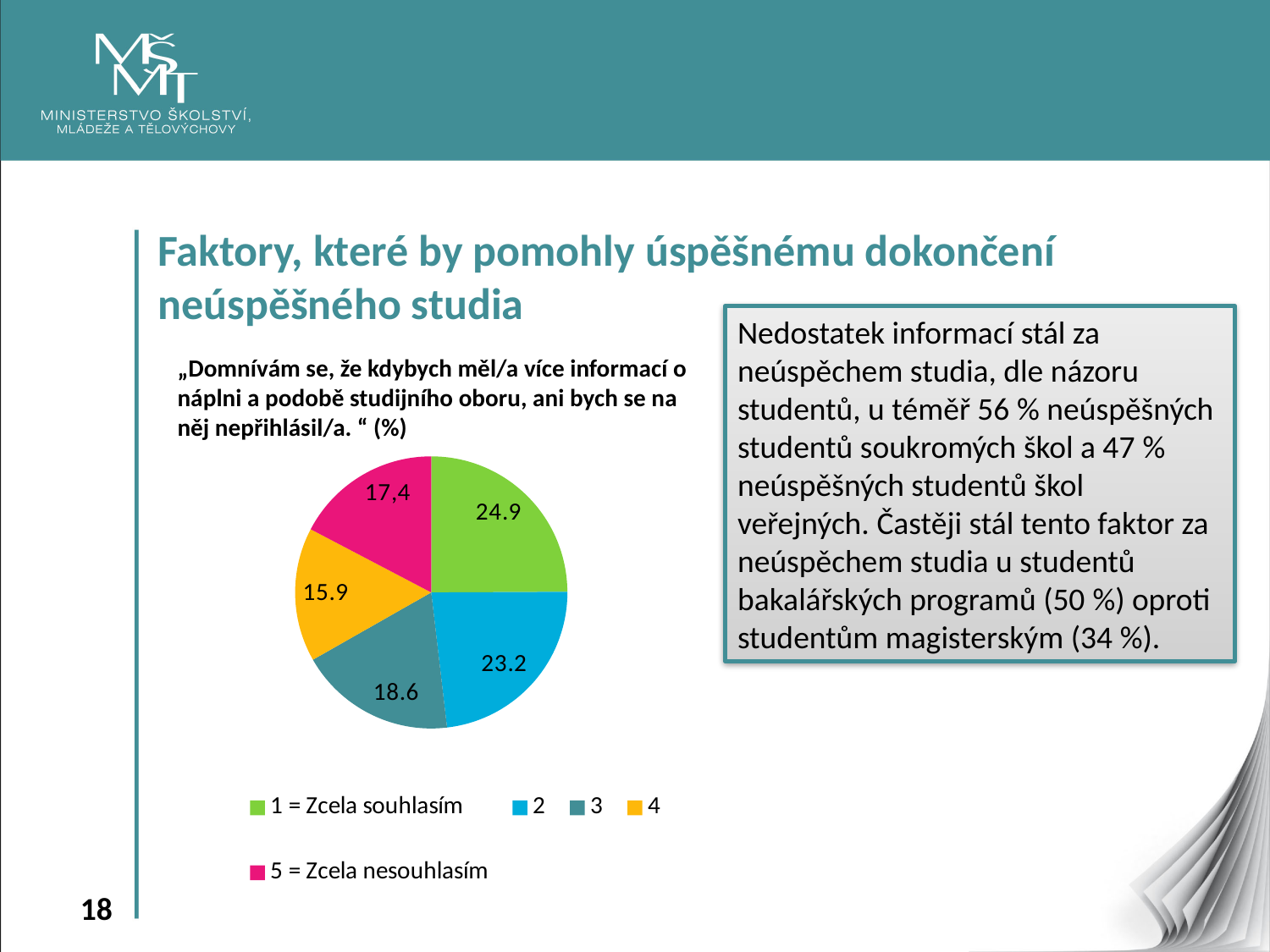
What is the value for the slice labelled "2"? 23.2 Which category has the smallest slice of the pie? 4 What is the value for the slice "5 = Zcela nesouhlasím"? 17,4 What is the value for the slice labelled "4"? 15.9 Which category has the largest slice of the pie? 1 = Zcela souhlasím What colour is the slice for "5 = Zcela nesouhlasím"? magenta (pink) What is the value for the slice labelled "3"? 18.6 What is the difference between the values for "1 = Zcela souhlasím" and "4"? 9.0 What kind of chart is shown on the slide? pie chart What is the value for the slice "1 = Zcela souhlasím"? 24.9 How many slices does the pie chart have? 5 Which is larger, the value for "3" or the value for "5 = Zcela nesouhlasím"? 3